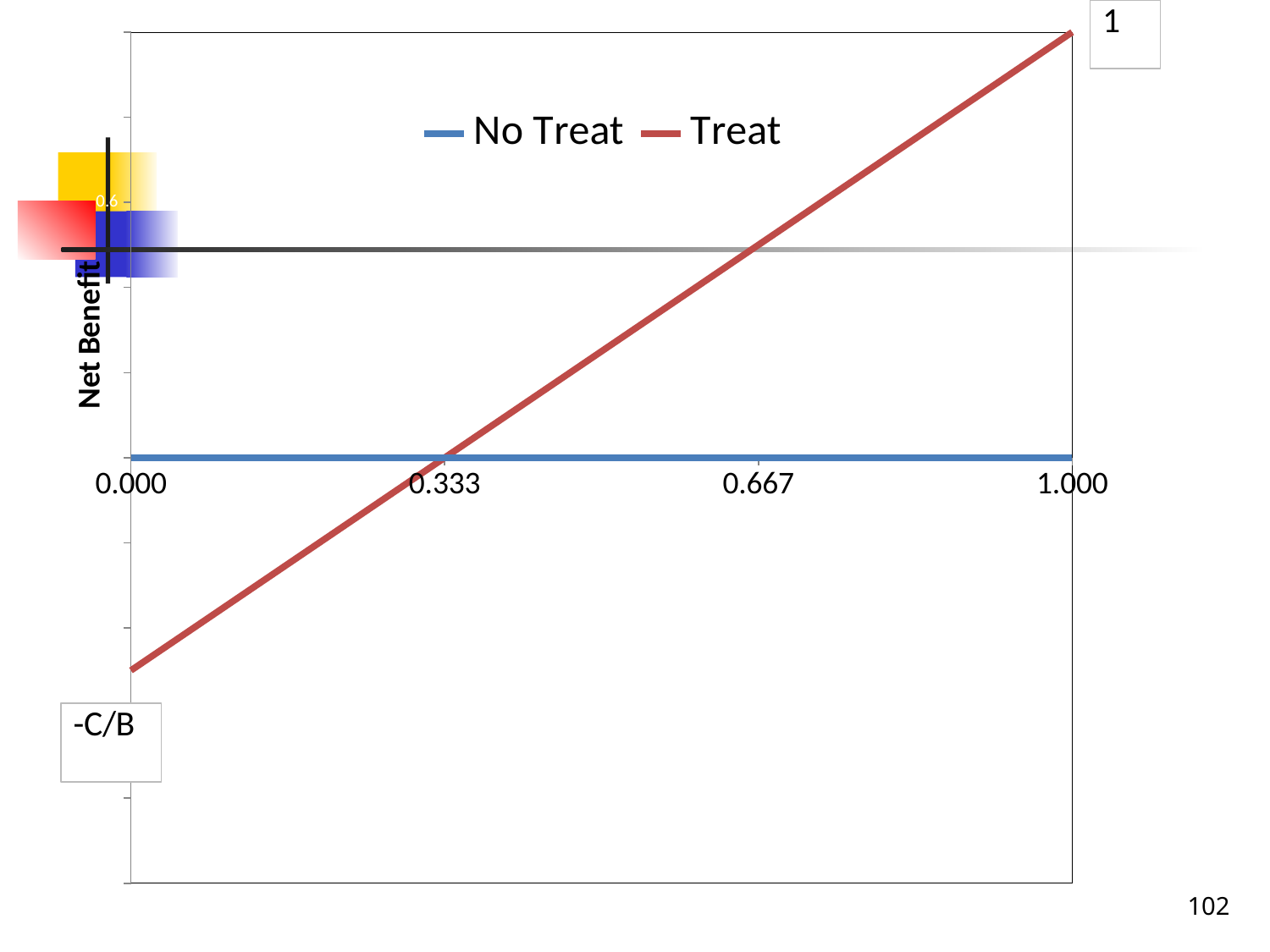
Does the No Treat line rise, fall, or stay flat along the x axis? stays flat How many series does the legend list? 2 Does the Treat line rise or fall as the x axis increases? rises What are the two series named in the legend? No Treat and Treat At which x-axis tick does the Treat line cross the No Treat line? 0.333 What kind of chart is shown on the slide? line chart What label is given to the value of the Treat line at x = 0.000? -C/B At x = 0.000, which series has the higher value, Treat or No Treat? No Treat What value is labelled at the right end of the Treat line, at x = 1.000? 1 How many tick labels are shown on the x axis? 4 At x = 1.000, which series has the higher value, Treat or No Treat? Treat What is the title of the y axis? Net Benefit